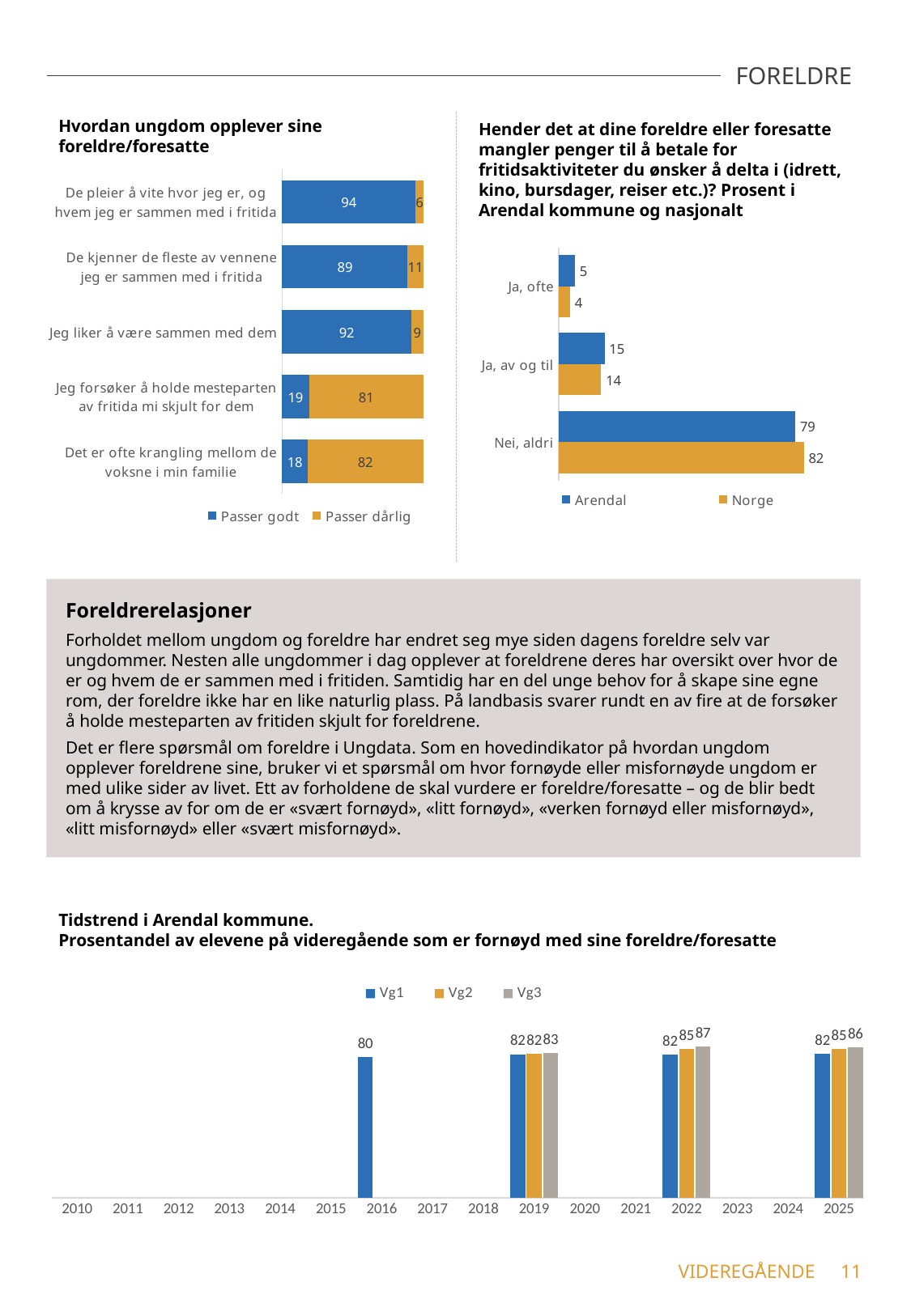
In the chart 'Hender det at dine foreldre eller foresatte mangler penger...', which is larger for 'Ja, av og til': Arendal or Norge? Arendal In the chart 'Tidstrend i Arendal kommune', what is the Vg3 value for 2022? 87 What kind of chart is 'Tidstrend i Arendal kommune'? Bar chart In the chart 'Hvordan ungdom opplever sine foreldre/foresatte', what is the 'Passer godt' value for 'De pleier å vite hvor jeg er, og hvem jeg er sammen med i fritida'? 94 In the chart 'Hvordan ungdom opplever sine foreldre/foresatte', what is the 'Passer dårlig' value for 'Jeg forsøker å holde mesteparten av fritida mi skjult for dem'? 81 In the chart 'Hender det at dine foreldre eller foresatte mangler penger...', how many series does the legend list? 2 In the chart 'Tidstrend i Arendal kommune', what is the Vg1 value for 2016? 80 In the chart 'Hender det at dine foreldre eller foresatte mangler penger...', what is the difference between Norge and Arendal for 'Nei, aldri'? 3 In the chart 'Hvordan ungdom opplever sine foreldre/foresatte', what is the difference between the 'Passer godt' values for 'De pleier å vite hvor jeg er' and 'De kjenner de fleste av vennene jeg er sammen med i fritida'? 5 In the chart 'Hvordan ungdom opplever sine foreldre/foresatte', which category has the lowest 'Passer godt' value? Det er ofte krangling mellom de voksne i min familie In the chart 'Hender det at dine foreldre eller foresatte mangler penger...', what is the value for Norge for 'Nei, aldri'? 82 In the chart 'Hvordan ungdom opplever sine foreldre/foresatte', how many categories are shown? 5